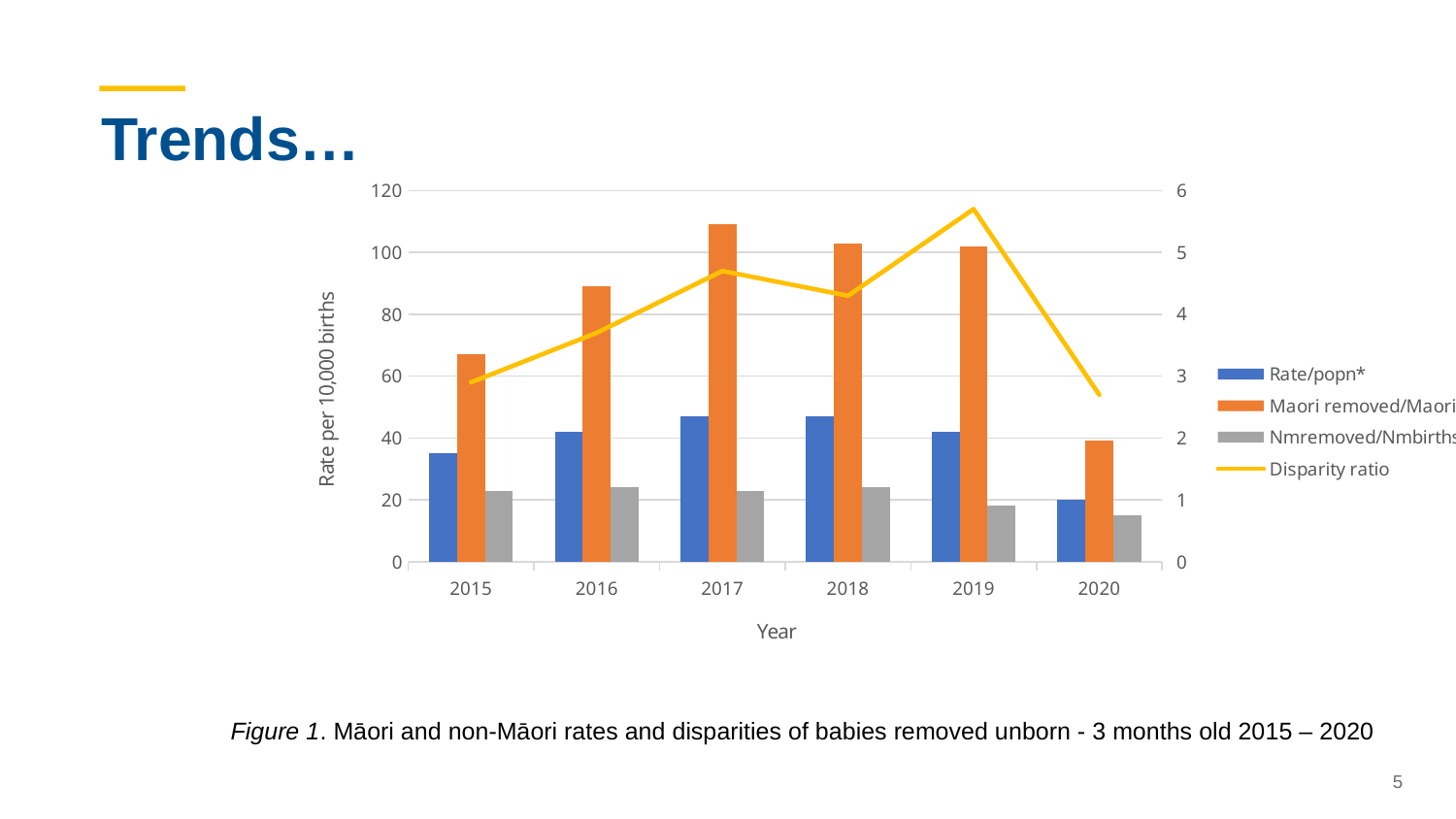
How many years are shown on the x axis? 6 What is the title of the left vertical axis? Rate per 10,000 births Is the Rate/popn* value for 2020 greater or less than 40? less In which year does the Disparity ratio line reach its highest point? 2019 Is the Disparity ratio for 2019 greater or less than 5? greater How many series does the legend list? 4 Does the Maori removed (orange) value rise or fall from 2019 to 2020? fall In which year is the Maori removed (orange) bar lowest? 2020 What kind of chart is shown on the slide? A bar chart combined with a line Is the Maori removed (orange) value for 2017 greater or less than 100? greater In which year is the Maori removed (orange) bar highest? 2017 Which year has the larger Maori removed (orange) value, 2015 or 2016? 2016